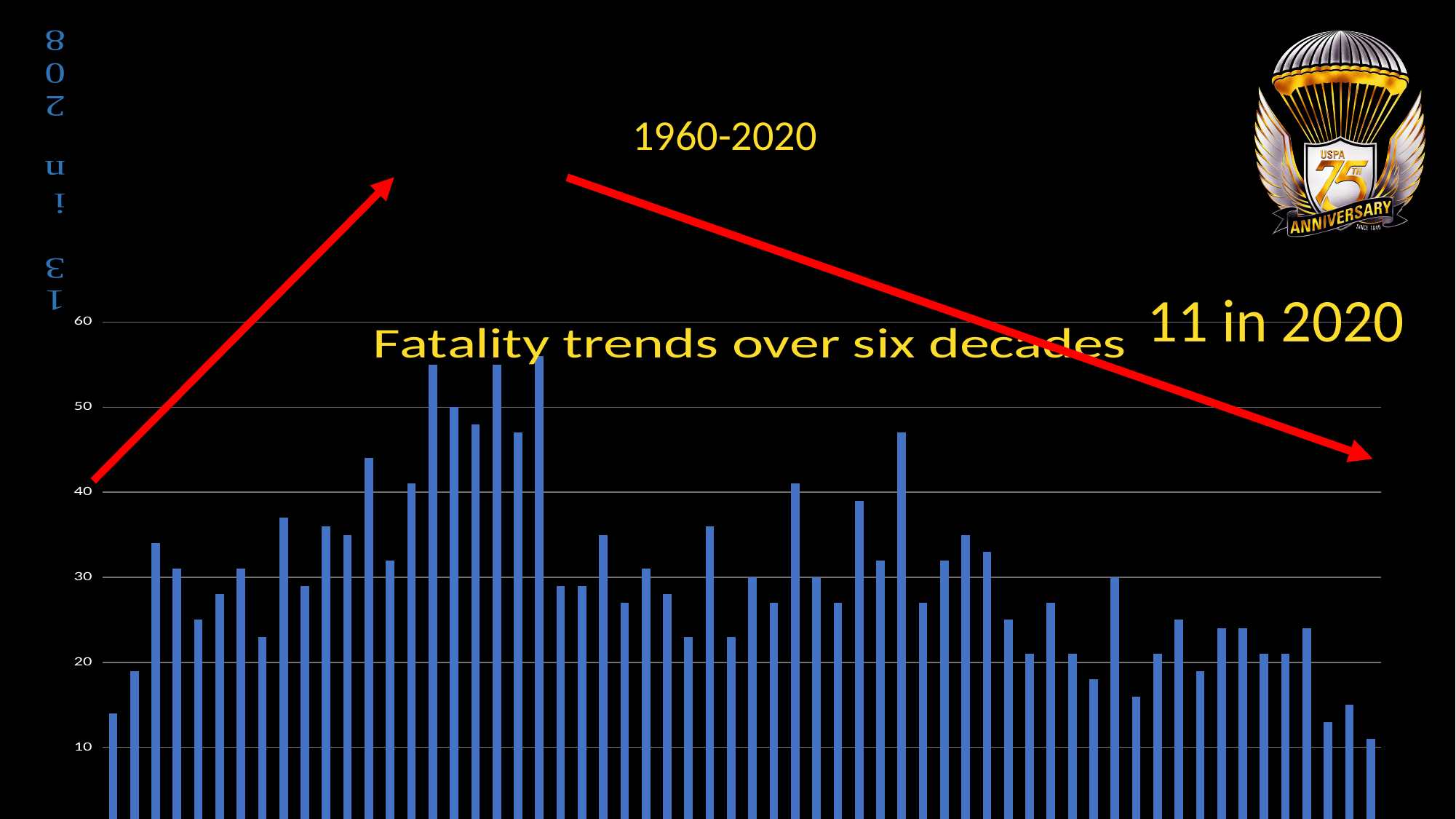
Is the value for 2020 greater or less than 20? less What kind of chart is shown on the slide? bar chart What is the title of the chart? Fatality trends over six decades What is the highest value shown on the y axis? 60 Over the most recent decades on the right side of the chart, do the values generally rise or fall? fall What year range does the chart cover, according to the subtitle? 1960-2020 What value does the slide annotate for 2020? 11 Is the tallest bar on the chart greater or less than 50? greater Is the shortest bar on the chart greater or less than 20? less